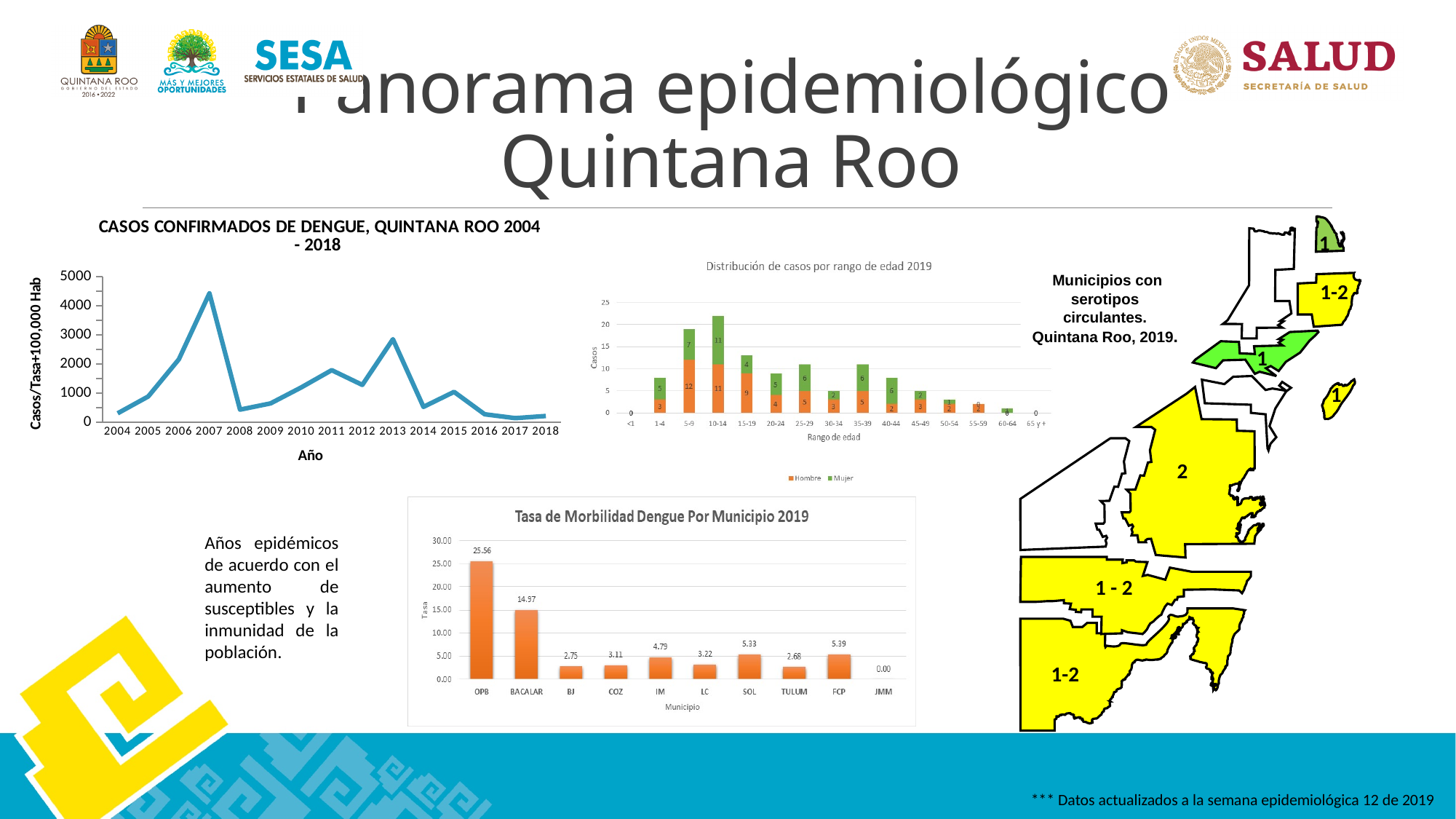
In the 'Tasa de Morbilidad Dengue Por Municipio 2019' chart, which municipality has the lowest rate? JMM In the 'Tasa de Morbilidad Dengue Por Municipio 2019' chart, what is the difference between the values for OPB and BACALAR? 10.59 In the 'Distribución de casos por rango de edad 2019' chart, which age range has the highest total number of cases? 10-14 What kind of chart is 'CASOS CONFIRMADOS DE DENGUE, QUINTANA ROO 2004 - 2018'? line chart In the 'Tasa de Morbilidad Dengue Por Municipio 2019' chart, which municipality has the highest rate? OPB In the 'Distribución de casos por rango de edad 2019' chart, what is the total number of cases in the 10-14 age range? 22 In the 'Tasa de Morbilidad Dengue Por Municipio 2019' chart, how many municipalities are shown on the x axis? 10 In the 'Distribución de casos por rango de edad 2019' chart, how many series does the legend list? 2 In the 'Tasa de Morbilidad Dengue Por Municipio 2019' chart, what is the value for OPB? 25.56 In the 'Tasa de Morbilidad Dengue Por Municipio 2019' chart, which is larger, the value for IM or the value for COZ? IM In the 'Distribución de casos por rango de edad 2019' chart, how many Hombre cases are in the 5-9 age range? 12 In the 'CASOS CONFIRMADOS DE DENGUE, QUINTANA ROO 2004 - 2018' chart, is the value for 2007 greater or less than 4000? greater